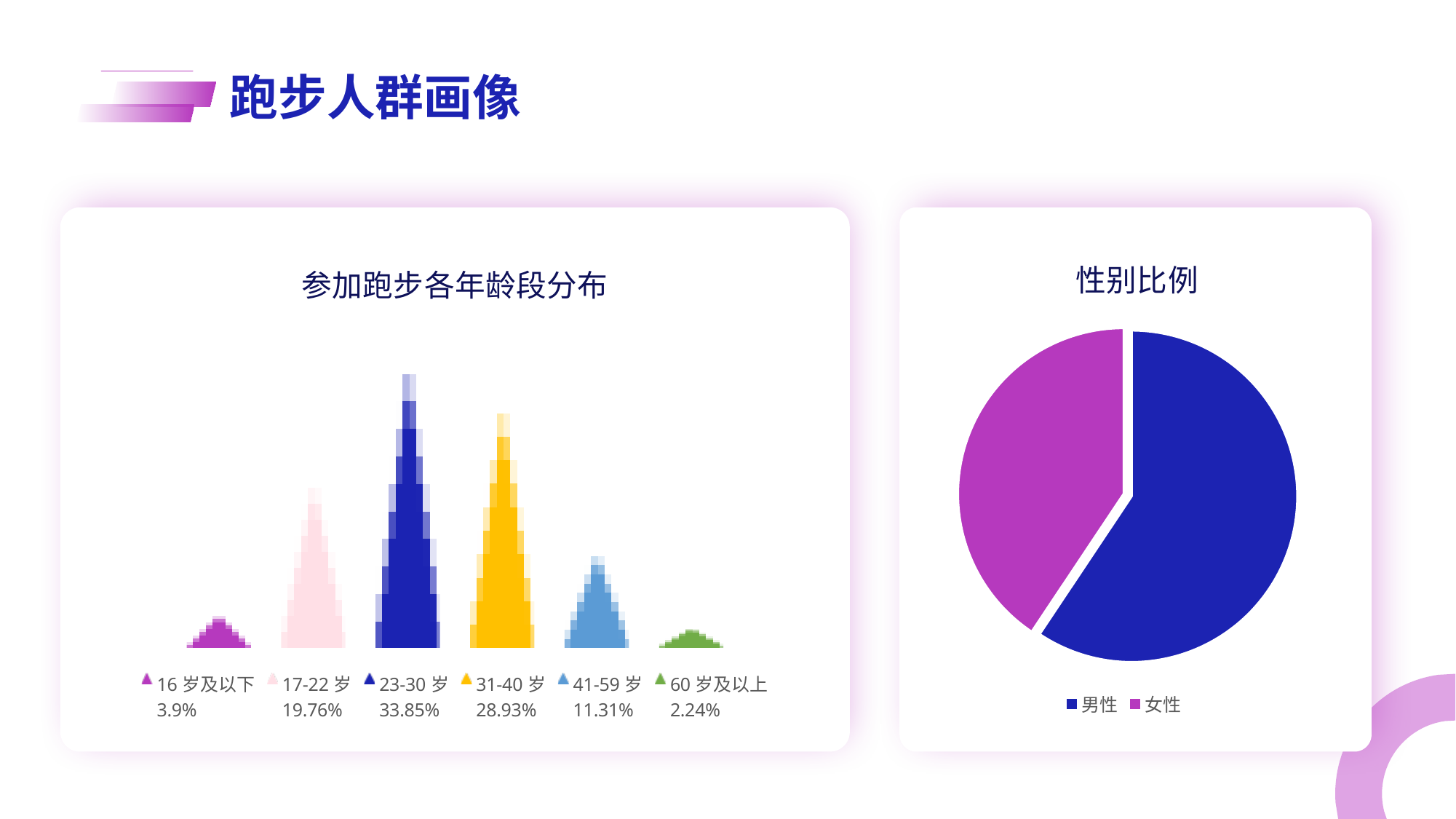
In the chart titled 参加跑步各年龄段分布, what is the difference between the values for 17-22 岁 and 41-59 岁? 8.45% In the chart titled 参加跑步各年龄段分布, what is the value for 17-22 岁? 19.76% In the chart titled 参加跑步各年龄段分布, what is the value for 60 岁及以上? 2.24% In the chart titled 参加跑步各年龄段分布, what is the difference between the values for 23-30 岁 and 31-40 岁? 4.92% In the pie chart titled 性别比例, which slice is larger, 男性 or 女性? 男性 In the chart titled 参加跑步各年龄段分布, what is the value for 23-30 岁? 33.85% What kind of chart is the chart titled 性别比例? Pie chart In the chart titled 参加跑步各年龄段分布, which age group has the highest value? 23-30 岁 In the chart titled 参加跑步各年龄段分布, which is larger, the value for 16 岁及以下 or the value for 41-59 岁? 41-59 岁 In the chart titled 参加跑步各年龄段分布, which age group has the lowest value? 60 岁及以上 How many age groups are shown in the chart titled 参加跑步各年龄段分布? 6 How many entries does the legend of the chart titled 性别比例 list? 2